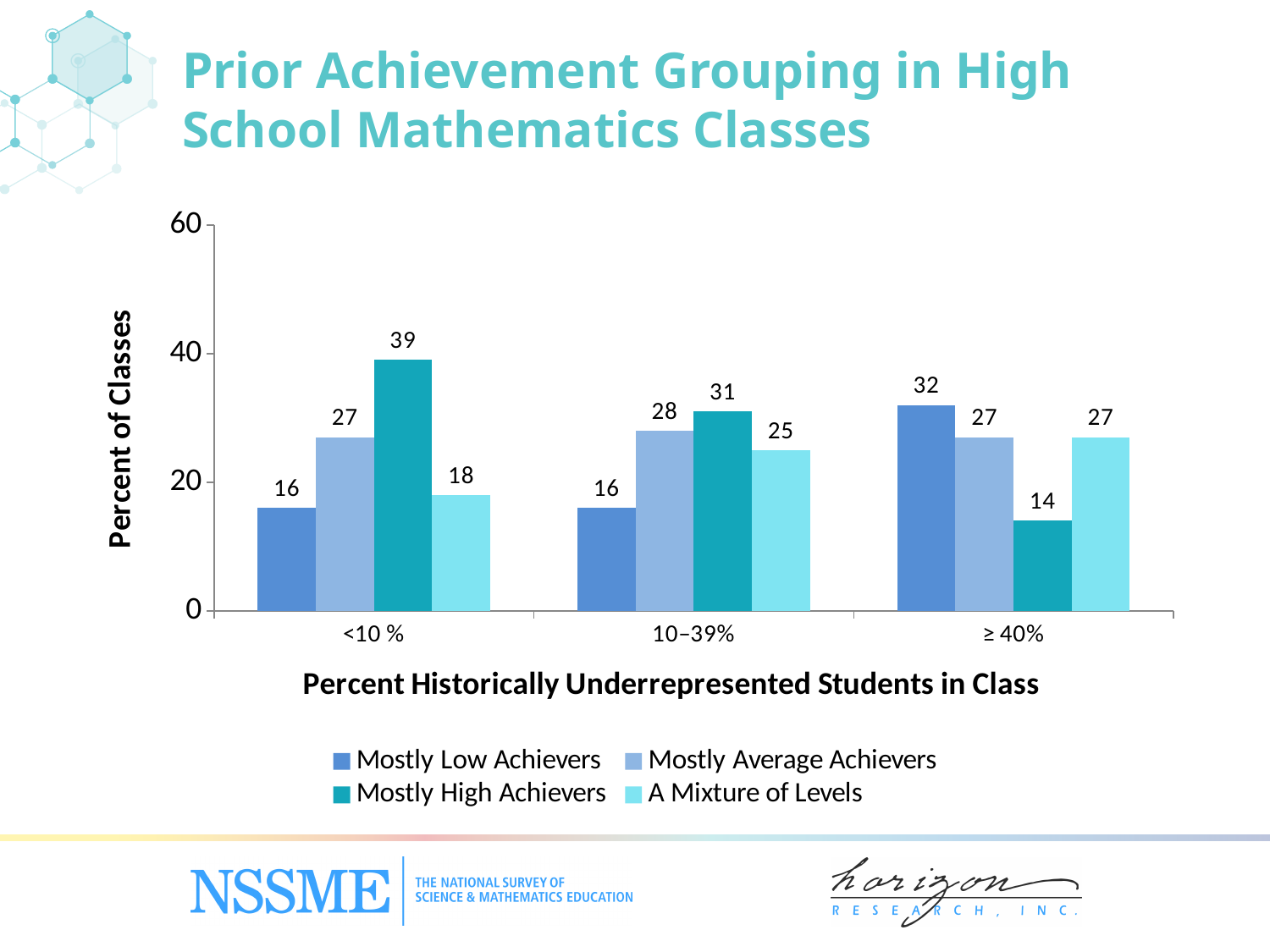
Does the Mostly Low Achievers value rise or fall from the 10–39% category to the ≥ 40% category? Rise What is the label of the y axis? Percent of Classes What is the value for Mostly Low Achievers in the ≥ 40% category? 32 How many series does the legend list? 4 What is the difference between the Mostly High Achievers values for the <10 % and ≥ 40% categories? 25 How many categories are shown on the x axis? 3 Which series has the highest value in the <10 % category? Mostly High Achievers Which series has the lowest value in the ≥ 40% category? Mostly High Achievers What is the value for A Mixture of Levels in the 10–39% category? 25 Which is larger: Mostly Low Achievers in the ≥ 40% category or Mostly High Achievers in the 10–39% category? Mostly Low Achievers in the ≥ 40% category What kind of chart is shown on the slide? Bar chart What percent of classes with <10 % historically underrepresented students are Mostly High Achievers? 39